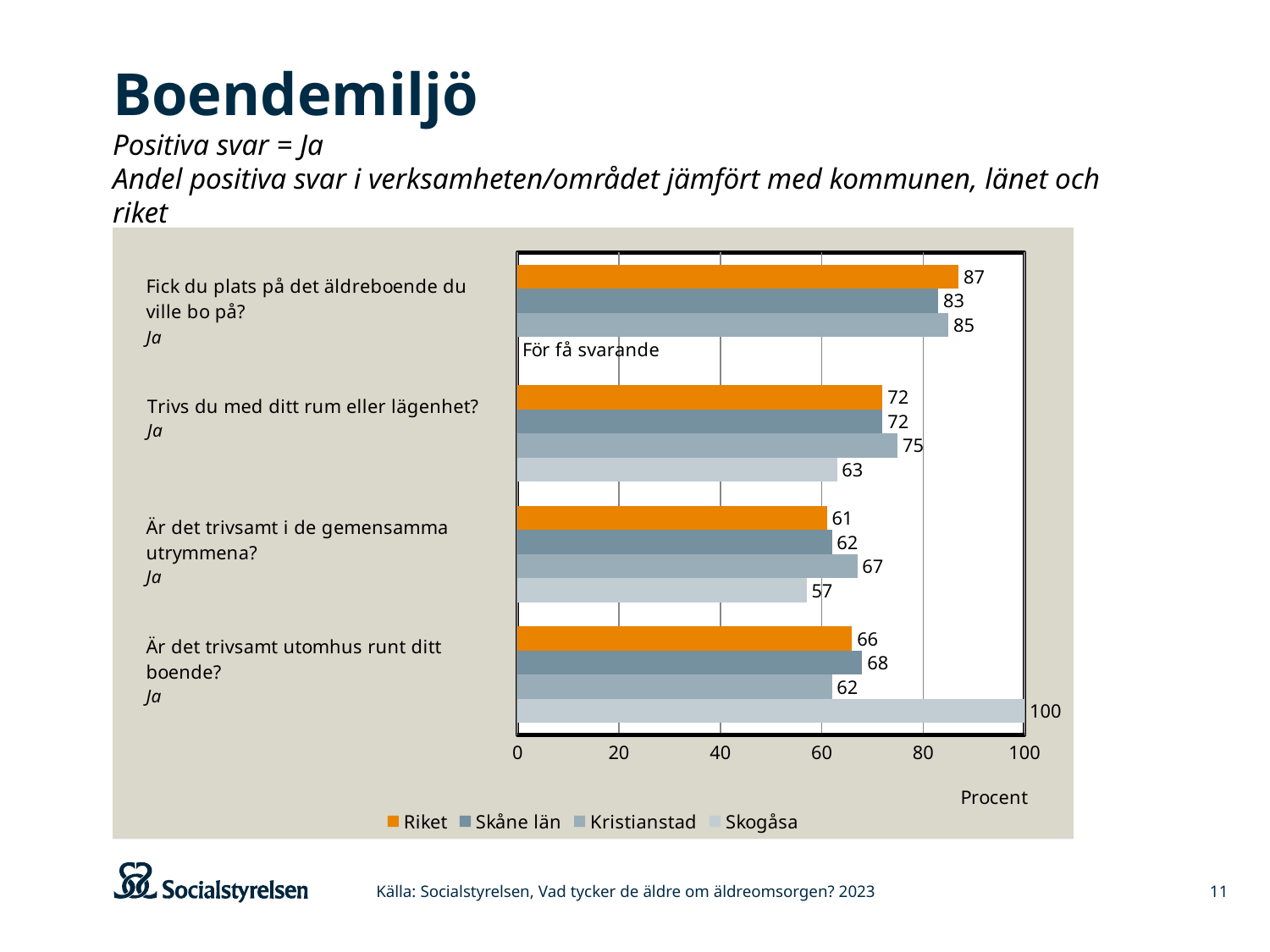
What is the value for Skogåsa on "Är det trivsamt utomhus runt ditt boende?"? 100 How many series does the legend list? 4 What kind of chart is shown on the slide? Bar chart What is the difference between Kristianstad and Skogåsa on "Trivs du med ditt rum eller lägenhet?"? 12 What is the value for Kristianstad on "Trivs du med ditt rum eller lägenhet?"? 75 Which series has the highest value on "Är det trivsamt utomhus runt ditt boende?"? Skogåsa What is shown for Skogåsa on "Fick du plats på det äldreboende du ville bo på?"? För få svarande What is the value for Riket on "Fick du plats på det äldreboende du ville bo på?"? 87 Which series has the lowest value on "Är det trivsamt i de gemensamma utrymmena?"? Skogåsa What is the value for Skåne län on "Är det trivsamt i de gemensamma utrymmena?"? 62 On "Är det trivsamt utomhus runt ditt boende?", which is larger: Skåne län or Kristianstad? Skåne län What unit label is shown below the x axis? Procent